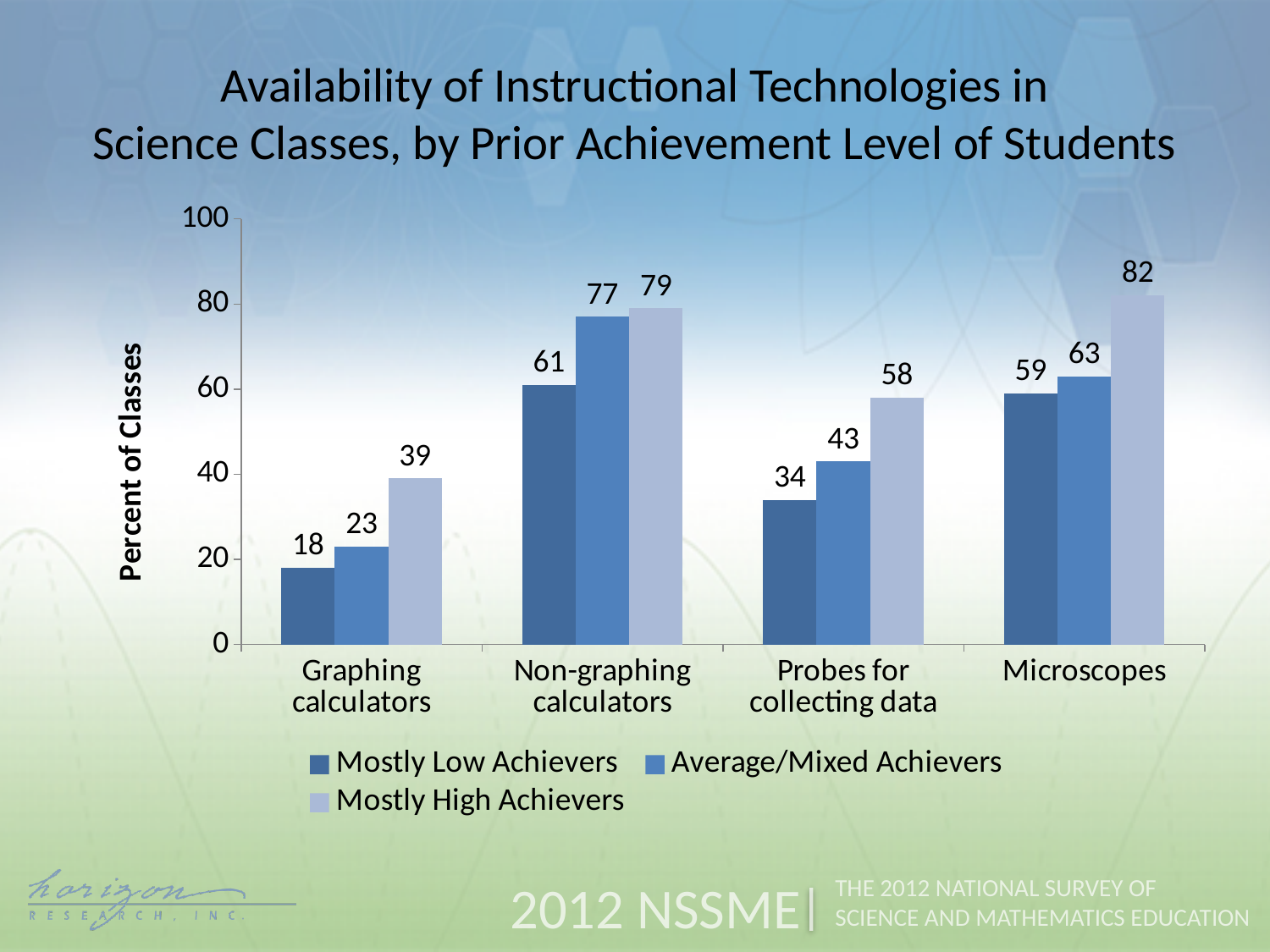
How many categories are shown on the x axis? 4 Which is larger: the Average/Mixed Achievers value for Non-graphing calculators or for Microscopes? Non-graphing calculators Is the value for Mostly Low Achievers in the Microscopes category greater or less than 40? greater How many series does the legend list? 3 What is the value for Mostly Low Achievers in the Graphing calculators category? 18 Which category has the highest value for Mostly Low Achievers? Non-graphing calculators What is the value for Mostly High Achievers in the Microscopes category? 82 What is the label of the y axis? Percent of Classes Which category has the lowest value for Mostly High Achievers? Graphing calculators What kind of chart is shown on the slide? bar chart What is the difference between the Mostly High Achievers and Mostly Low Achievers values for Probes for collecting data? 24 What is the value for Average/Mixed Achievers in the Probes for collecting data category? 43